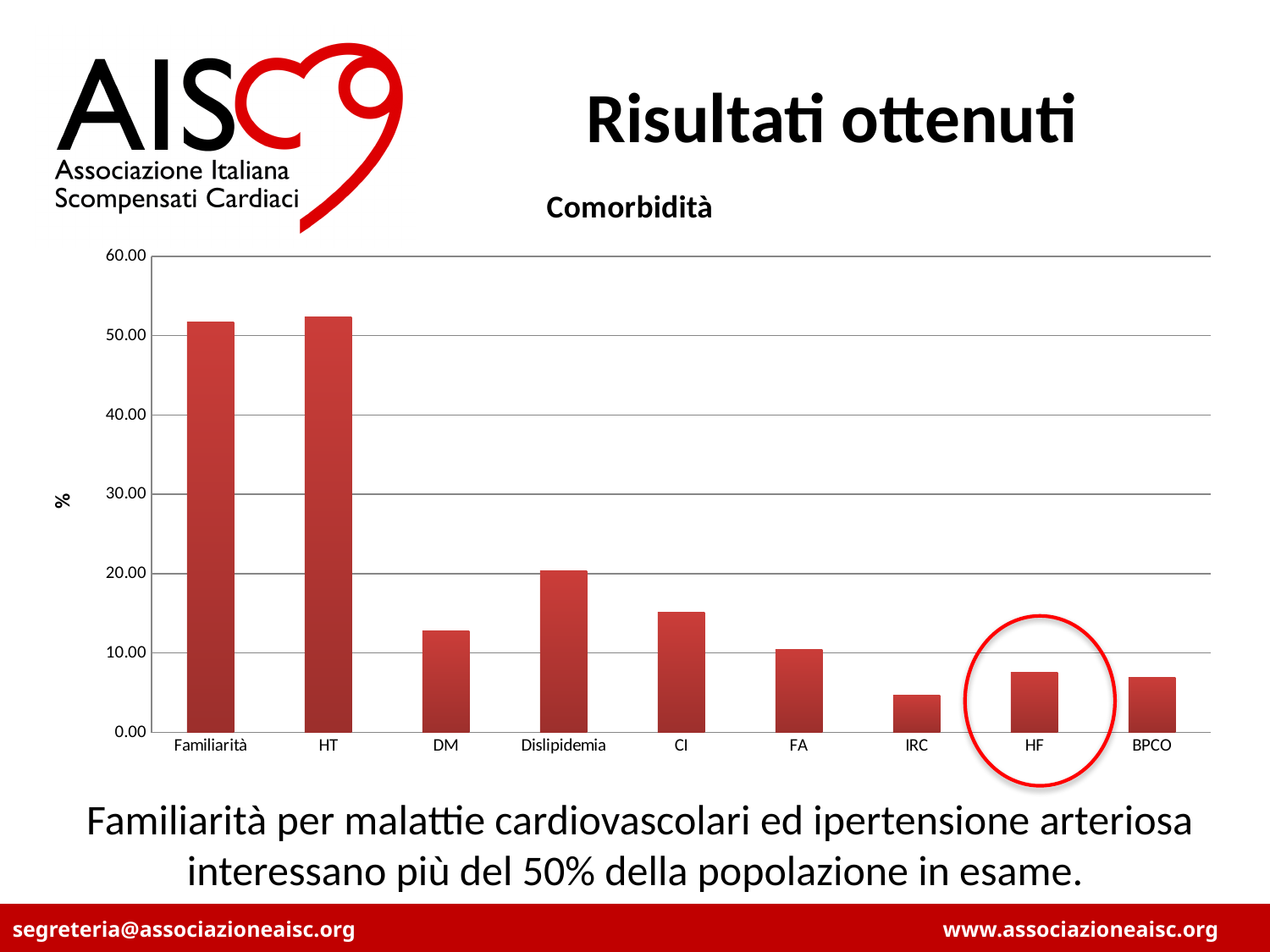
Which category has the lowest value in the chart? IRC What is the title of the chart? Comorbidità What kind of chart is shown on the slide? bar chart Is the value for IRC greater or less than 10.00? less Is the value for HT greater or less than 50.00? greater Which has the larger value, IRC or HF? HF How many categories are plotted on the x axis of the chart? 9 Which has the larger value, Dislipidemia or CI? Dislipidemia Is the value for Dislipidemia greater or less than 30.00? less Which category's bar is circled in red on the chart? HF